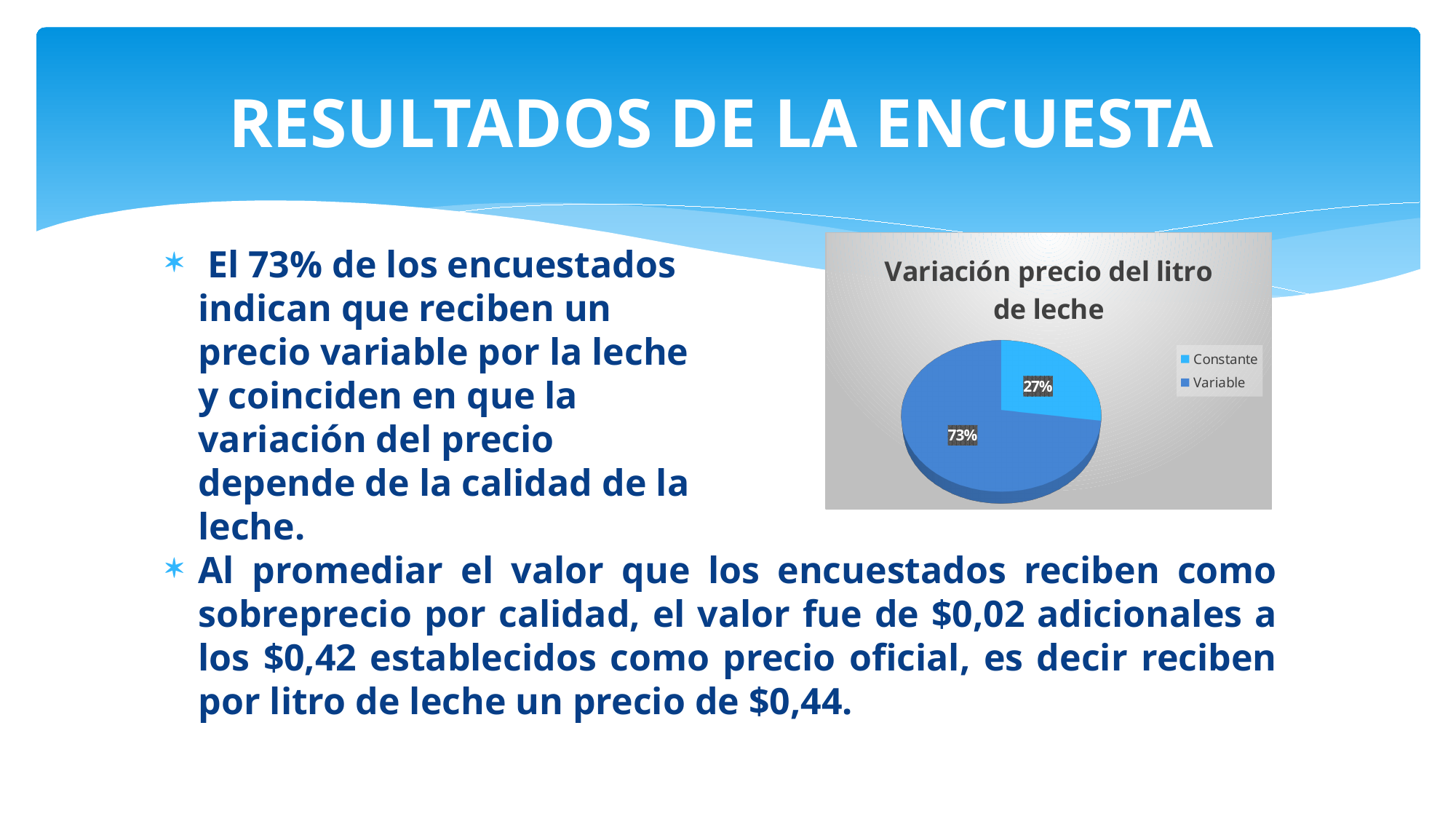
Which category has the largest share of the pie? Variable How many categories does the legend list? 2 How many slices does the pie chart have? 2 What percentage of the pie is labelled Constante? 27% Which legend entry is shown in the lighter blue colour? Constante Which slice is larger, Constante or Variable? Variable Which category has the smallest share of the pie? Constante What is the difference in percentage points between the Variable and Constante slices? 46 What share of the pie does the Constante slice represent? 27% What is the title of the chart? Variación precio del litro de leche What percentage of the pie is labelled Variable? 73% What type of chart is shown on the slide? Pie chart